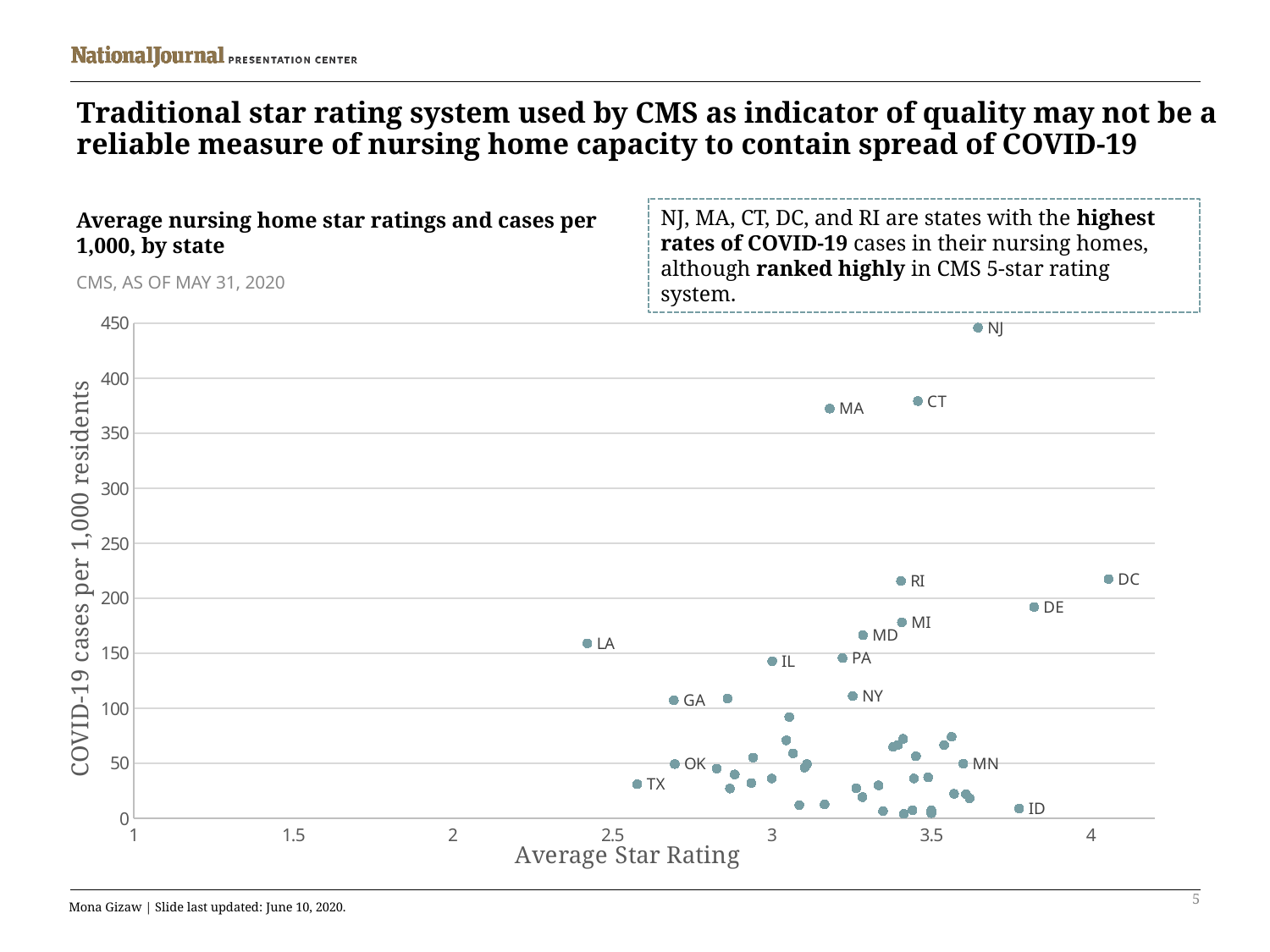
Is the value of COVID-19 cases per 1,000 residents for DC greater or less than 200? greater Which state has the highest COVID-19 cases per 1,000 residents? NJ Is the value of COVID-19 cases per 1,000 residents for TX greater or less than 50? less Which labeled state has the highest average star rating? DC Which has more COVID-19 cases per 1,000 residents, LA or TX? LA Is the value of COVID-19 cases per 1,000 residents for ID greater or less than 50? less Which labeled state has the lowest average star rating? LA What is the label of the x axis of the chart? Average Star Rating Which has more COVID-19 cases per 1,000 residents, NJ or MA? NJ What kind of chart is shown on the slide? scatter chart